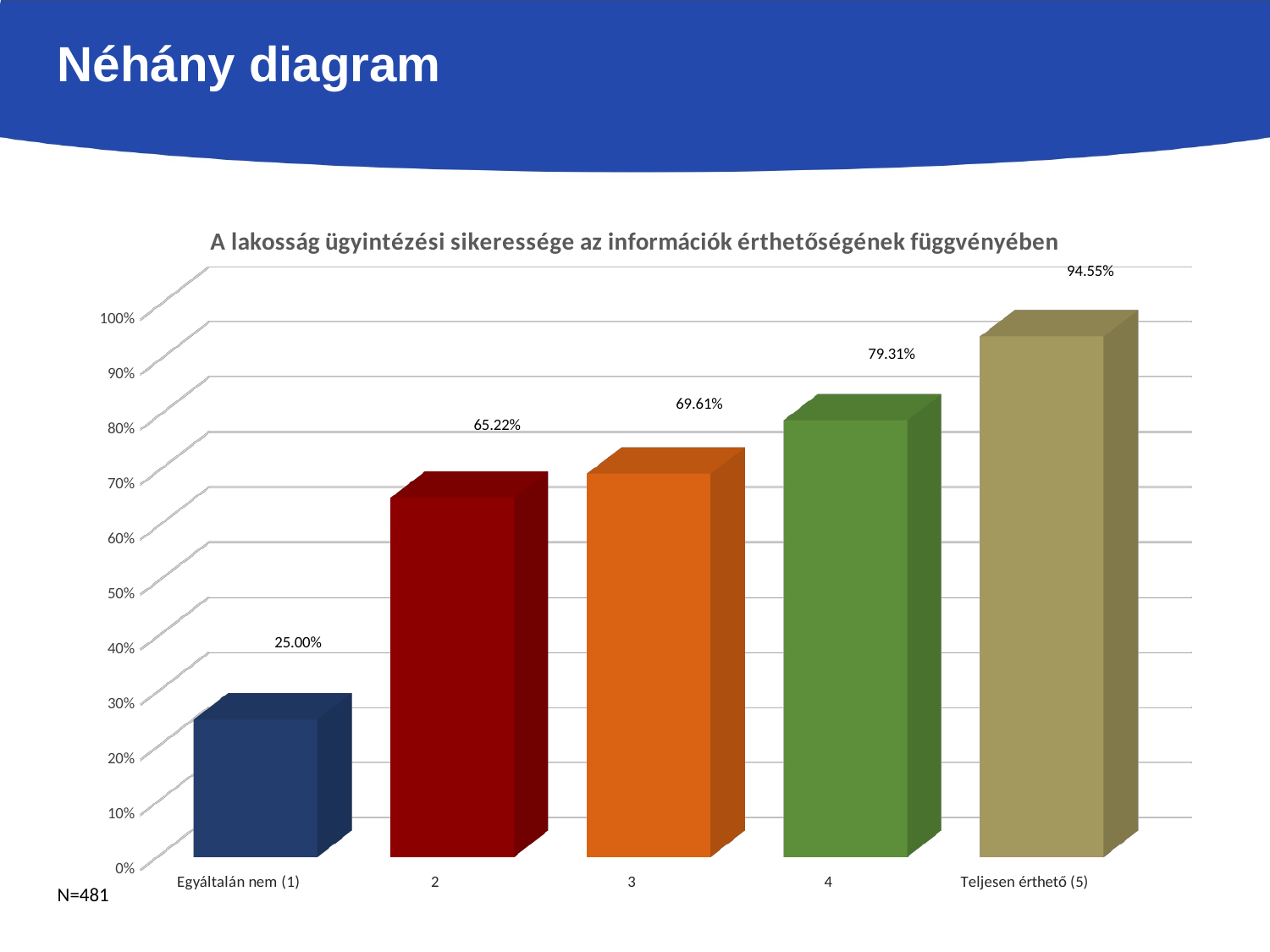
Which is larger, the value for category 3 or the value for category 4? 4 What is the value for category 4? 79.31% What is the value for category 2? 65.22% Do the values rise or fall from left to right along the x axis? rise Which category has the lowest value? Egyáltalán nem (1) What is the value for category 3? 69.61% What is the difference between the values for "Teljesen érthető (5)" and "Egyáltalán nem (1)"? 69.55% What kind of chart is shown? bar chart How many categories are shown on the x axis? 5 What is the value for "Teljesen érthető (5)"? 94.55% What is the value for "Egyáltalán nem (1)"? 25.00% Which category has the highest value? Teljesen érthető (5)